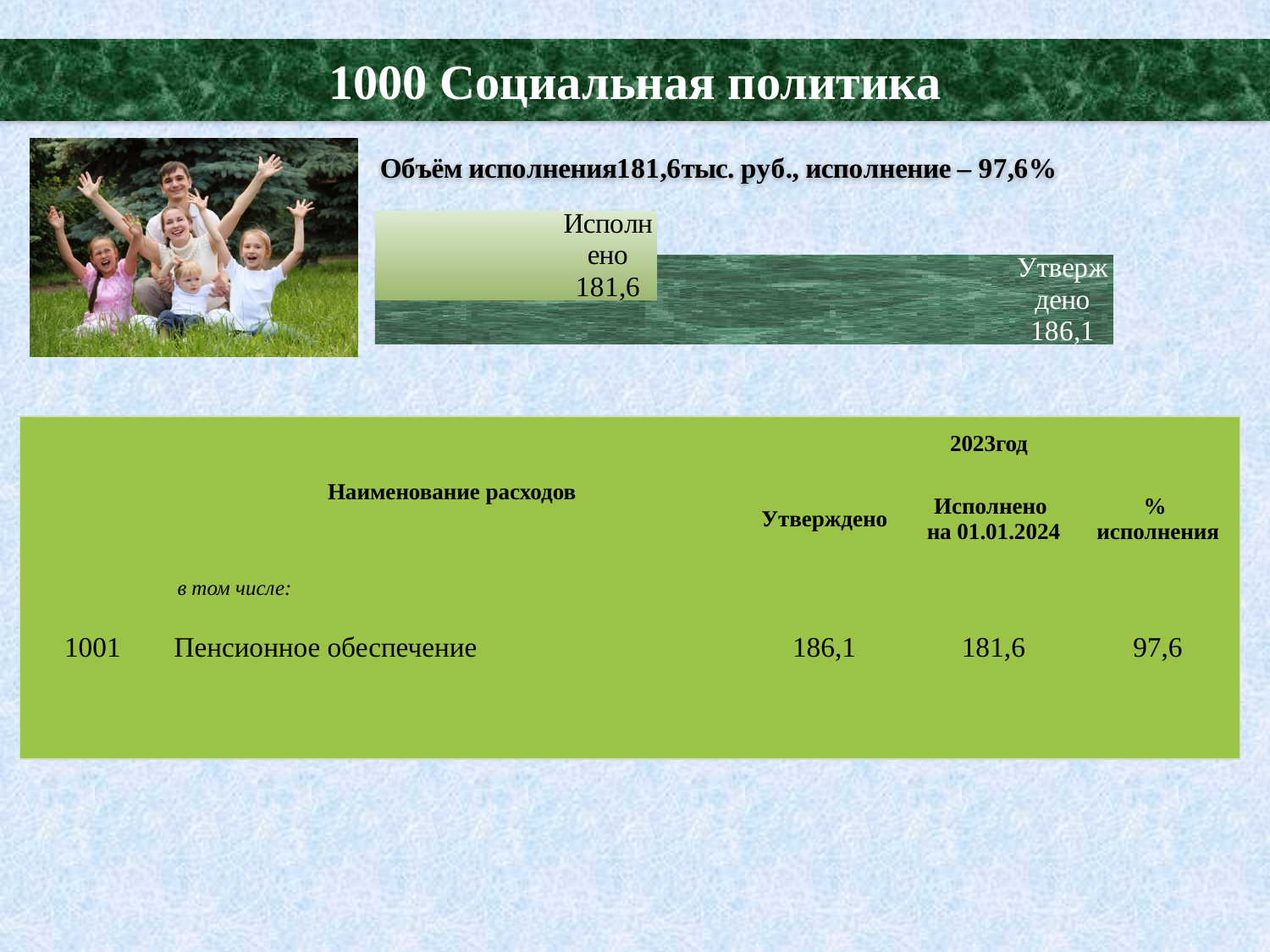
What value is shown for Утверждено in the chart? 186,1 Which bar in the chart is longer, the one labelled Исполнено or the one labelled Утверждено? Утверждено What value is shown for Исполнено in the chart? 181,6 Which bar in the chart has the higher value, Исполнено or Утверждено? Утверждено Which category in the chart has the highest value? Утверждено How many bars are plotted in the chart? 2 What is the difference between the Утверждено and Исполнено values in the chart? 4,5 What type of chart is shown on the slide? bar chart Which category in the chart has the lowest value? Исполнено What are the two labels shown on the bars of the chart? Исполнено and Утверждено